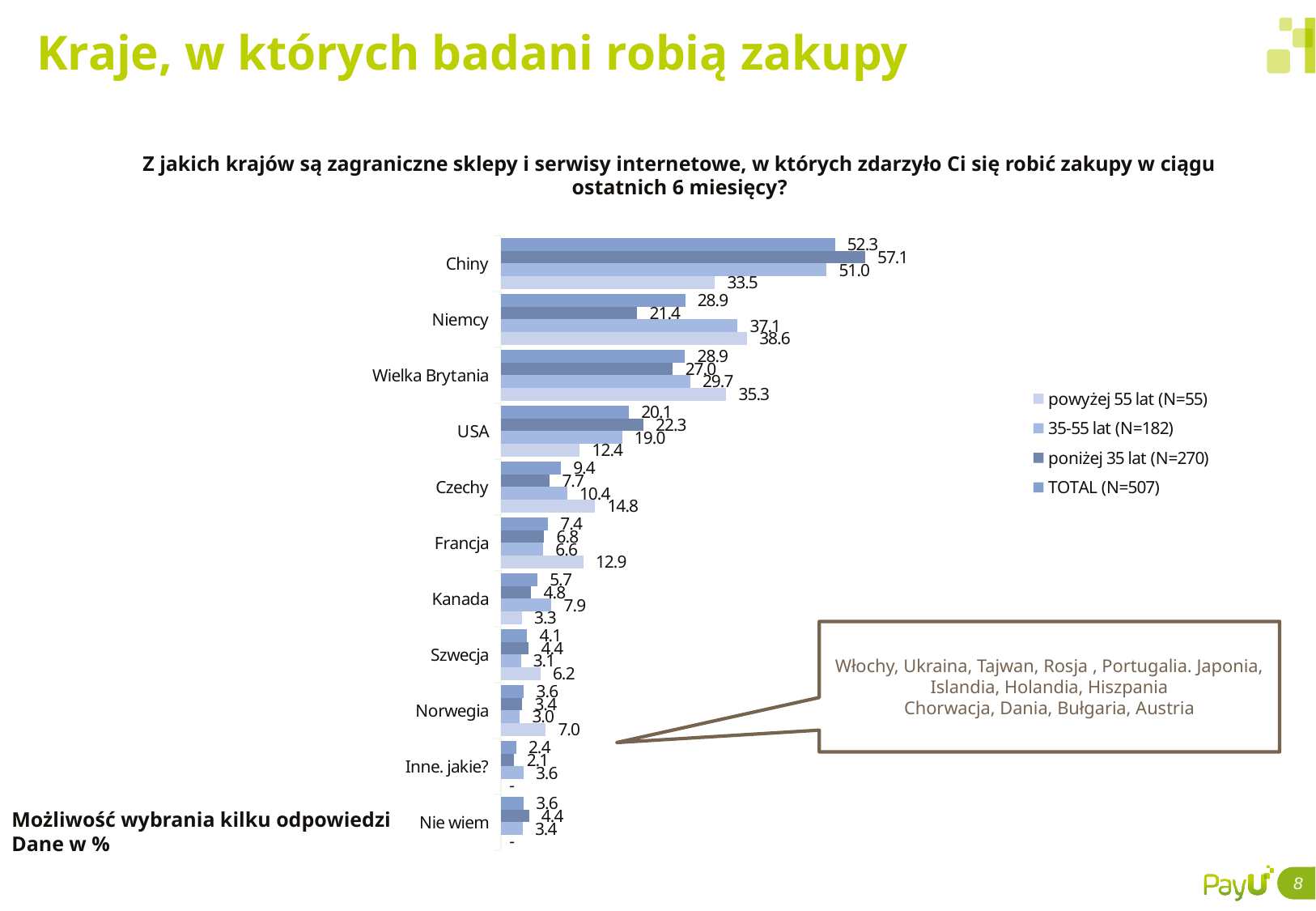
Which category has the lowest TOTAL (N=507) value? Inne. jakie? What is the 35-55 lat (N=182) value for Wielka Brytania? 29.7 What kind of chart is shown on the slide? Bar chart What is the value for Niemcy among respondents aged powyżej 55 lat (N=55)? 38.6 What is the value for USA among respondents aged poniżej 35 lat (N=270)? 22.3 For Niemcy, which is larger: the 35-55 lat (N=182) value or the poniżej 35 lat (N=270) value? 35-55 lat (N=182) How many countries/categories are listed on the chart? 11 What is the difference between the poniżej 35 lat (N=270) value and the powyżej 55 lat (N=55) value for Chiny? 23.6 What is the TOTAL (N=507) value for Chiny? 52.3 What is the sample size (N) given in the legend for the TOTAL series? 507 How many series does the legend list? 4 Which country has the highest TOTAL (N=507) value? Chiny